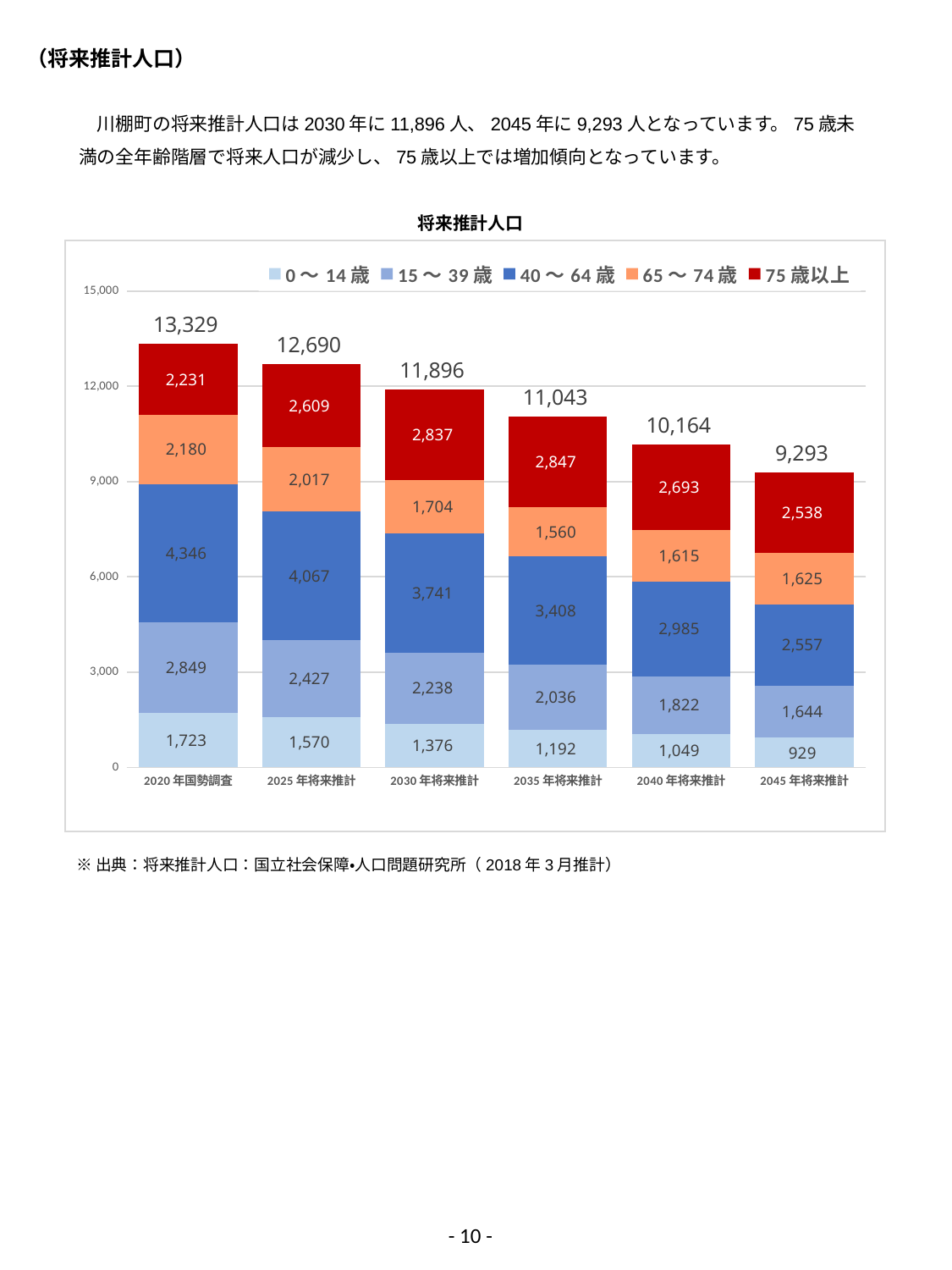
How many categories (years) are shown on the x axis? 6 Which year has the lowest total population? 2045年将来推計 What is the value for 0～14歳 in 2045年将来推計? 929 What is the total of the stacked bar for 2030年将来推計? 11,896 What is the value for 40～64歳 in 2020年国勢調査? 4,346 Which year has the highest total population? 2020年国勢調査 What type of chart is shown on the slide? Stacked bar chart What is the value for 75歳以上 in 2035年将来推計? 2,847 How many series does the legend list? 5 Which is larger: 15～39歳 in 2040年将来推計 or 65～74歳 in 2040年将来推計? 15～39歳 in 2040年将来推計 What is the difference between the total for 2020年国勢調査 and the total for 2045年将来推計? 4,036 Do the total values rise or fall from 2020 to 2045 along the x axis? Fall